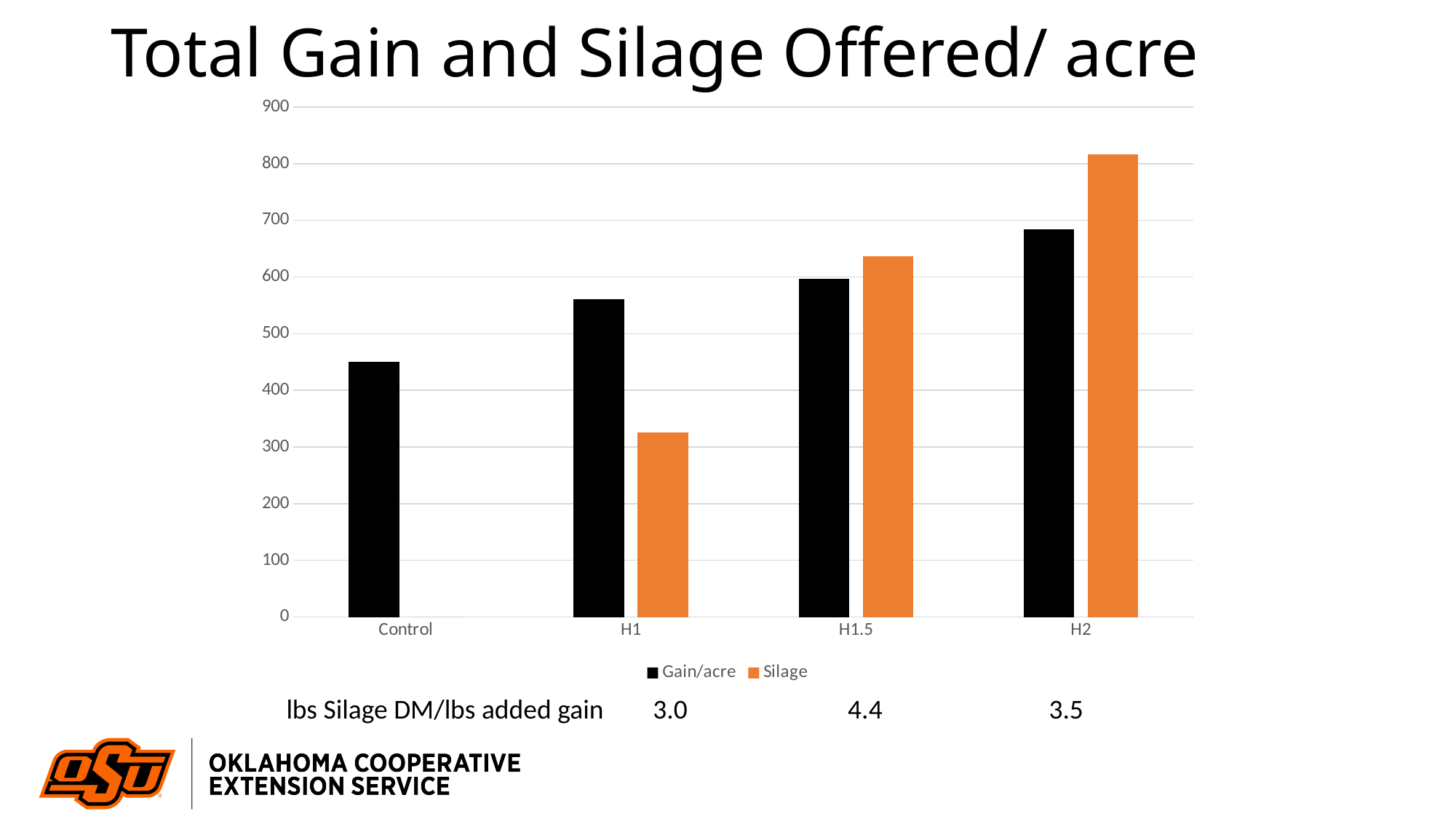
What is the title of the chart? Total Gain and Silage Offered/ acre What kind of chart is shown on the slide? bar chart Which category has the lowest Gain/acre value? Control Do the Gain/acre values rise or fall from Control to H2? rise How many series does the legend list? 2 For H1, which is larger, Gain/acre or Silage? Gain/acre Is the Gain/acre value for Control greater or less than 400? greater Is the Silage value for H2 greater or less than 800? greater How many categories are shown on the x axis? 4 Is the Silage value for H1 greater or less than 400? less Which category has the highest Silage value? H2 Which category has the highest Gain/acre value? H2